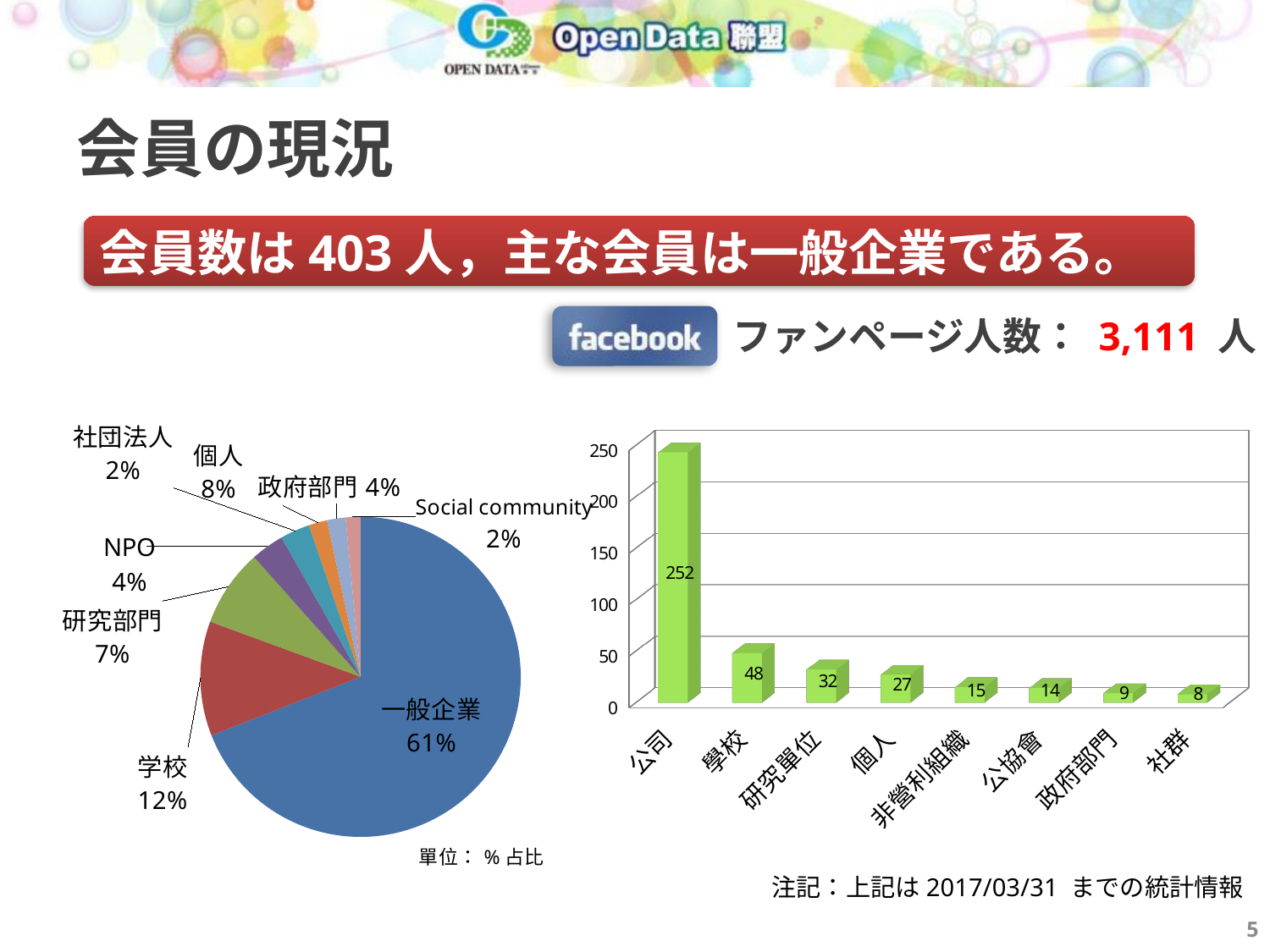
In the bar chart on the right, do the values rise or fall from left to right? fall In the bar chart on the right, which category has the highest value? 公司 In the pie chart on the left, what share does 一般企業 have? 61% What kind of chart is the chart on the right of the slide? bar chart In the bar chart on the right, what is the difference between the values for 學校 and 個人? 21 In the bar chart on the right, what is the value for 研究單位? 32 In the bar chart on the right, what is the value for 公司? 252 In the bar chart on the right, which is larger, the value for 非營利組織 or the value for 政府部門? 非營利組織 In the bar chart on the right, which category has the lowest value? 社群 In the bar chart on the right, how many categories are shown? 8 In the pie chart on the left, how many slices are there? 8 In the pie chart on the left, what share does 学校 have? 12%